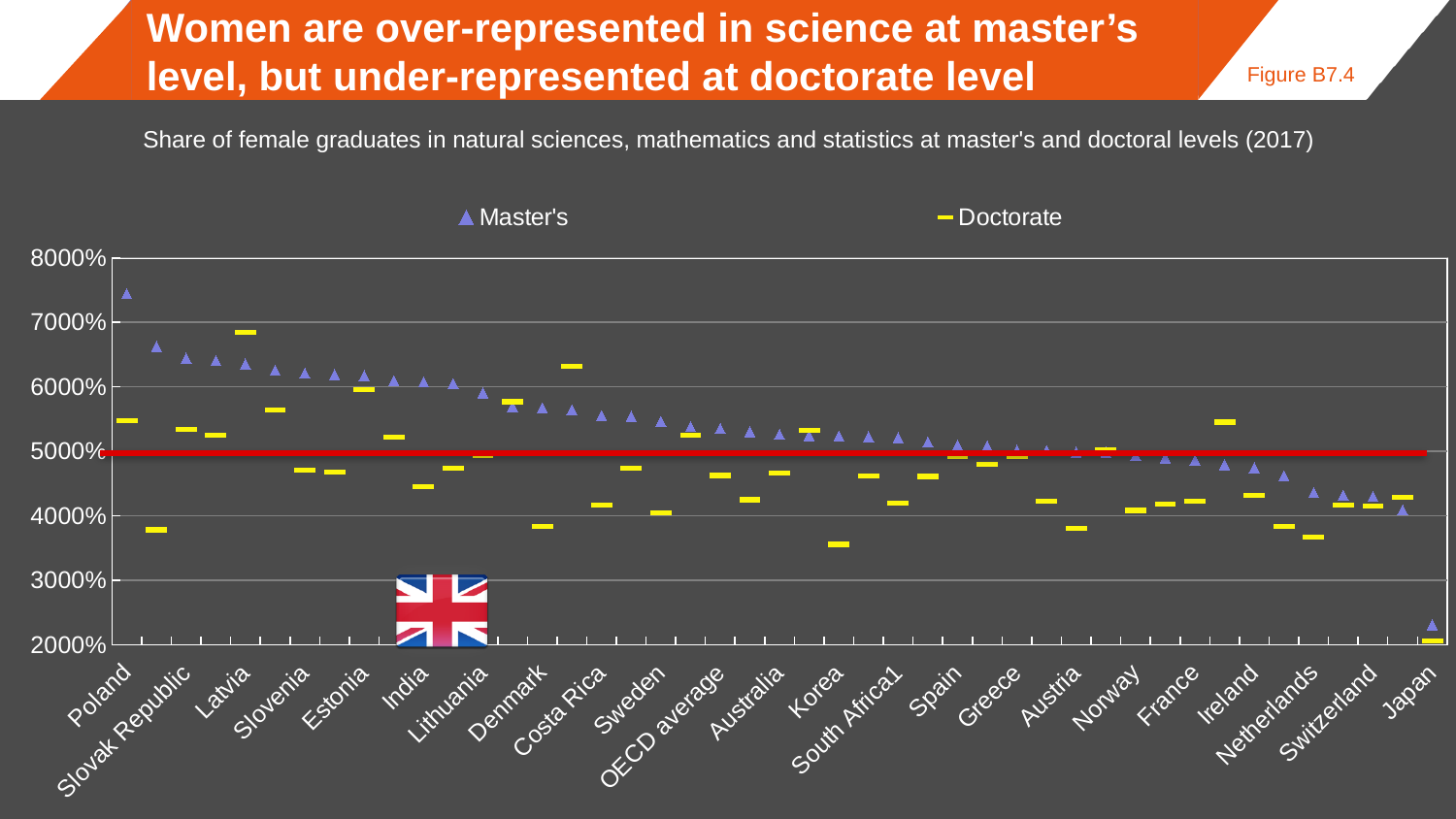
Which country has the highest Master's value? Poland Is the Doctorate value for Latvia greater or less than 6000%? greater How many series does the chart legend list? 2 Is the Master's value for Poland greater or less than 7000%? greater Which country has the lowest Master's value? Japan For Latvia, which is larger: the Master's value or the Doctorate value? Doctorate Do the Master's values generally rise or fall from left to right across the chart? fall Is the Doctorate value for Korea greater or less than 4000%? less What are the two series shown in the chart legend? Master's and Doctorate For Korea, which is larger: the Master's value or the Doctorate value? Master's Which country has the lowest Doctorate value? Japan